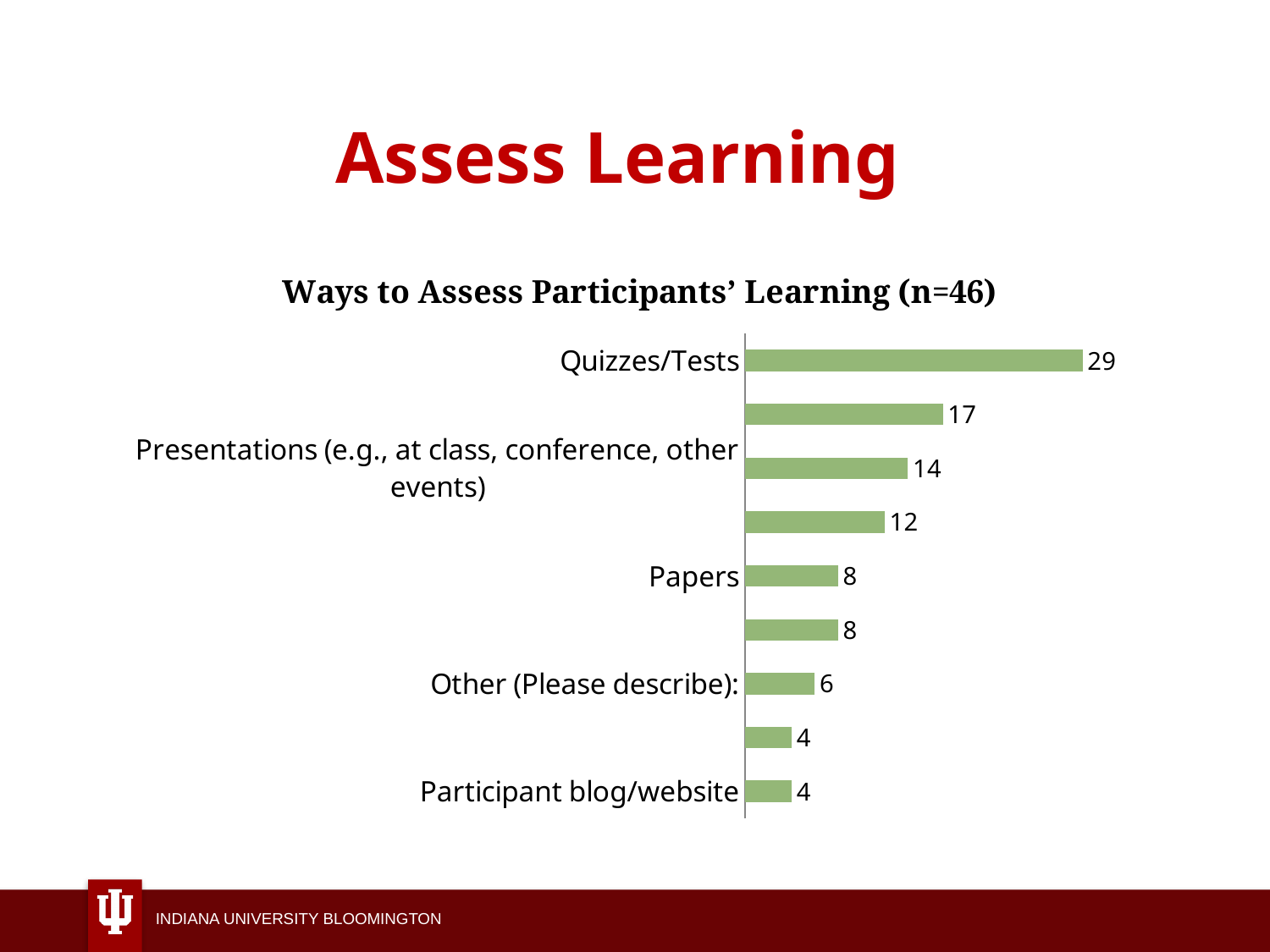
What is the title of the chart? Ways to Assess Participants' Learning (n=46) What is the value for Presentations (e.g., at class, conference, other events)? 14 Which is larger, the value for Presentations or the value for Papers? Presentations What is the difference between the values for Quizzes/Tests and Papers? 21 What type of chart is shown on the slide? bar chart What is the difference between the values for Papers and Participant blog/website? 4 What is the value for Quizzes/Tests? 29 How many bars are plotted in the chart? 9 Which category has the highest value? Quizzes/Tests What is the value for Participant blog/website? 4 What is the value for Papers? 8 What is the value for Other (Please describe):? 6